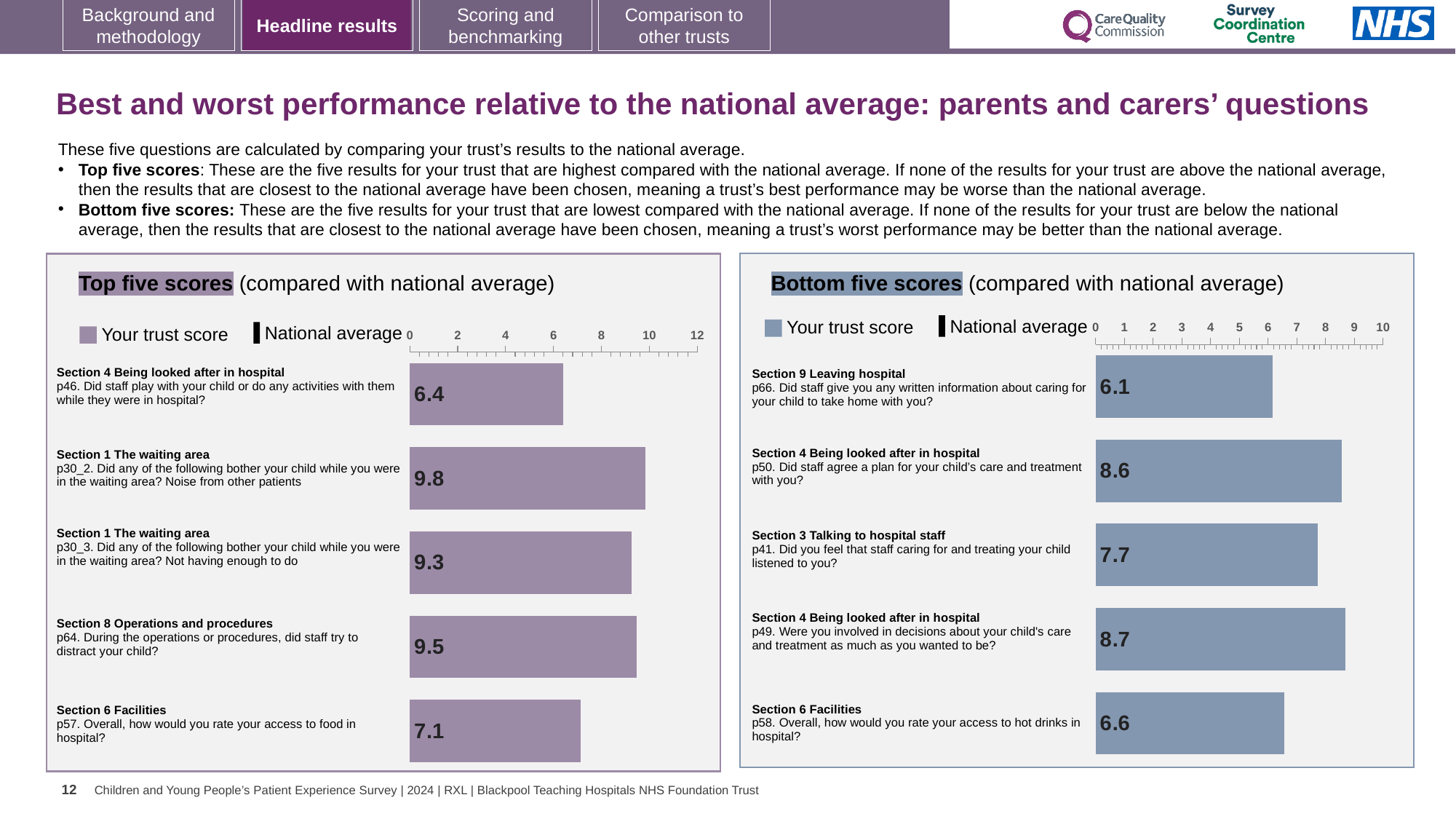
In the Bottom five scores chart, which question has the highest trust score? p49. Were you involved in decisions about your child's care and treatment as much as you wanted to be? In the Top five scores chart, what is the difference between the trust scores for p30_2 (Noise from other patients) and p57 (access to food in hospital)? 2.7 What type of chart is used in the Top five scores panel? Bar chart How many series does the legend of the Bottom five scores chart list? 2 In the Bottom five scores chart, which is larger: the trust score for p50 (Did staff agree a plan for your child's care and treatment with you) or for p66 (written information to take home)? p50 In the Top five scores chart, which question has the highest trust score? p30_2. Did any of the following bother your child while you were in the waiting area? Noise from other patients In the Bottom five scores chart, which question has the lowest trust score? p66. Did staff give you any written information about caring for your child to take home with you? In the Top five scores chart, which question has the lowest trust score? p46. Did staff play with your child or do any activities with them while they were in hospital? In the Top five scores chart, what is the trust score for p46 (Did staff play with your child or do any activities with them while they were in hospital)? 6.4 In the Top five scores chart, how many questions are plotted? 5 In the Bottom five scores chart, what is the trust score for p41 (Did you feel that staff caring for and treating your child listened to you)? 7.7 In the Bottom five scores chart, is the trust score for p58 (access to hot drinks in hospital) greater or less than 7? less